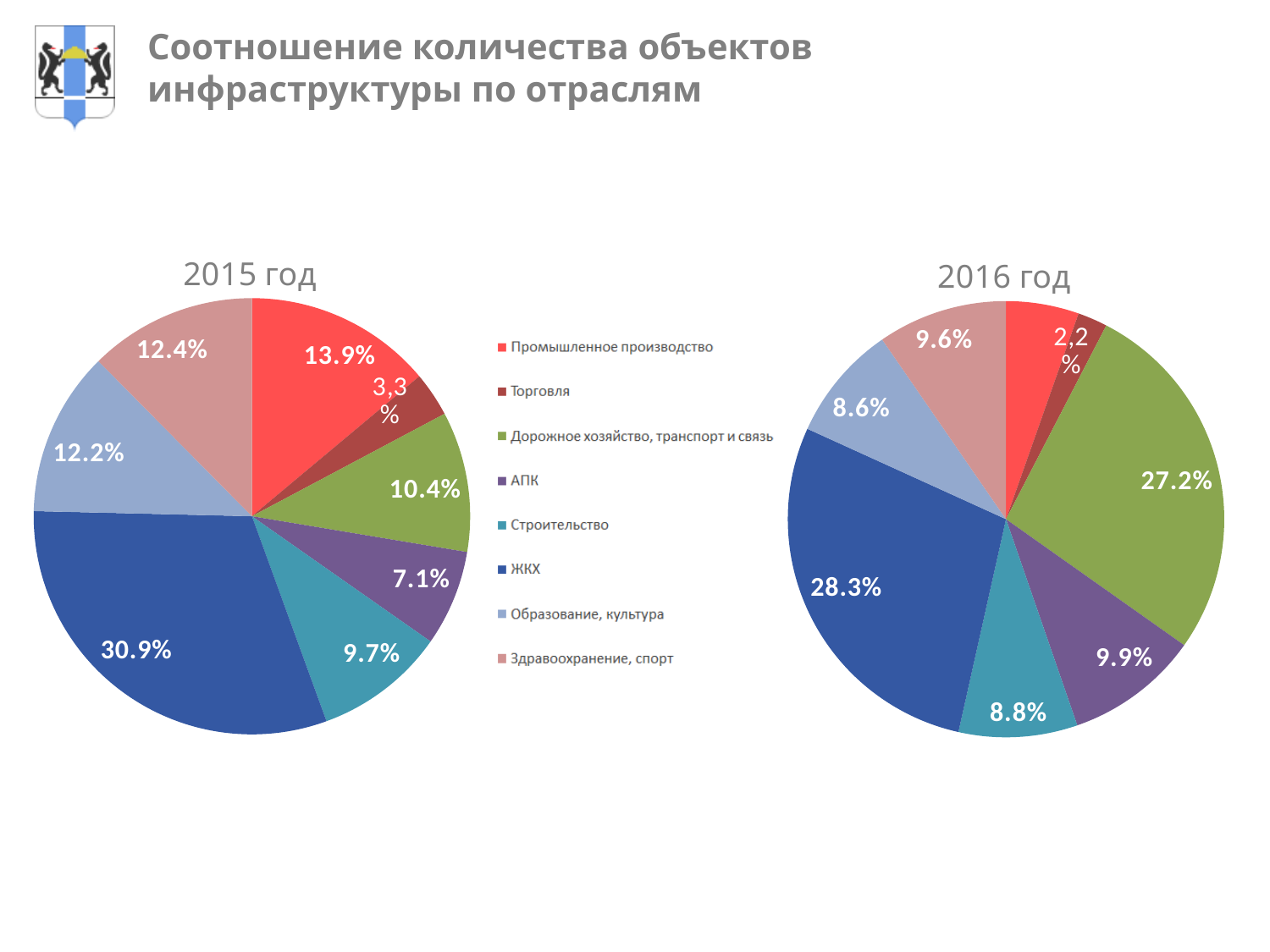
In the 2016 год pie chart, what is the share of АПК? 9.9% In the 2015 год pie chart, which category has the largest slice? ЖКХ By how many percentage points did the share of Дорожное хозяйство, транспорт и связь change from the 2015 год chart to the 2016 год chart? 16.8 percentage points In the 2016 год pie chart, what is the share of Дорожное хозяйство, транспорт и связь? 27.2% In the 2015 год pie chart, which is larger: Образование, культура or Здравоохранение, спорт? Здравоохранение, спорт In the 2016 год pie chart, what is the share of Строительство? 8.8% In the 2015 год pie chart, what is the share of Дорожное хозяйство, транспорт и связь? 10.4% What type of chart is used on this slide? Pie chart In the 2015 год pie chart, which category has the smallest slice? Торговля In the 2016 год pie chart, what share does ЖКХ have? 28.3% In the 2015 год pie chart, what share does ЖКХ have? 30.9% How many categories does the legend list? 8